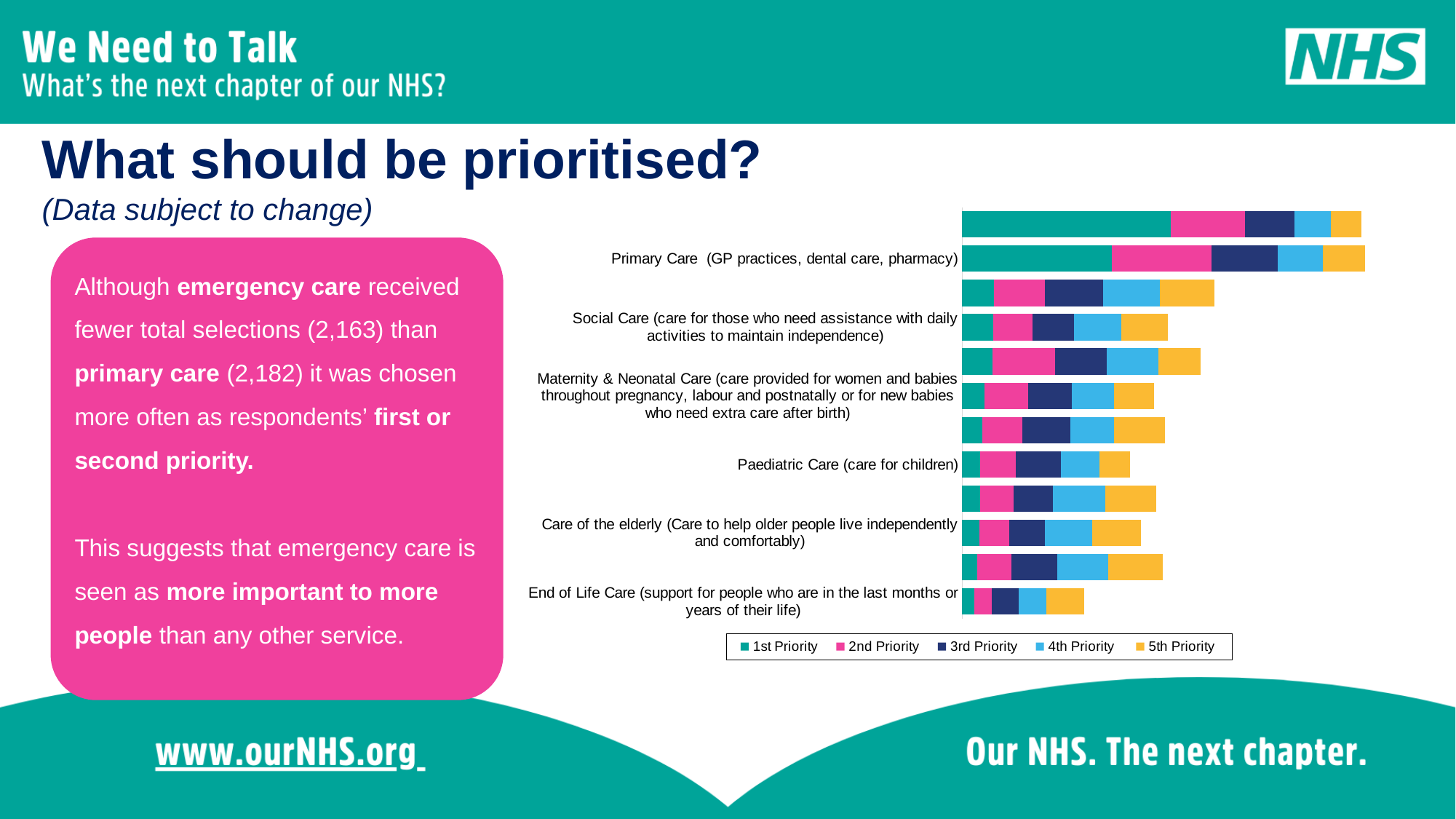
Which labelled category has the shortest total bar in the chart? End of Life Care How many series does the chart's legend list? 5 What colour represents 5th Priority in the chart? Yellow Which has a longer total bar: Primary Care or Paediatric Care? Primary Care In the End of Life Care bar, which priority segment is the smallest? 1st Priority What kind of chart is shown on the slide? Stacked bar chart In the Primary Care bar, which priority segment is the largest? 1st Priority Which series is listed first in the chart's legend? 1st Priority